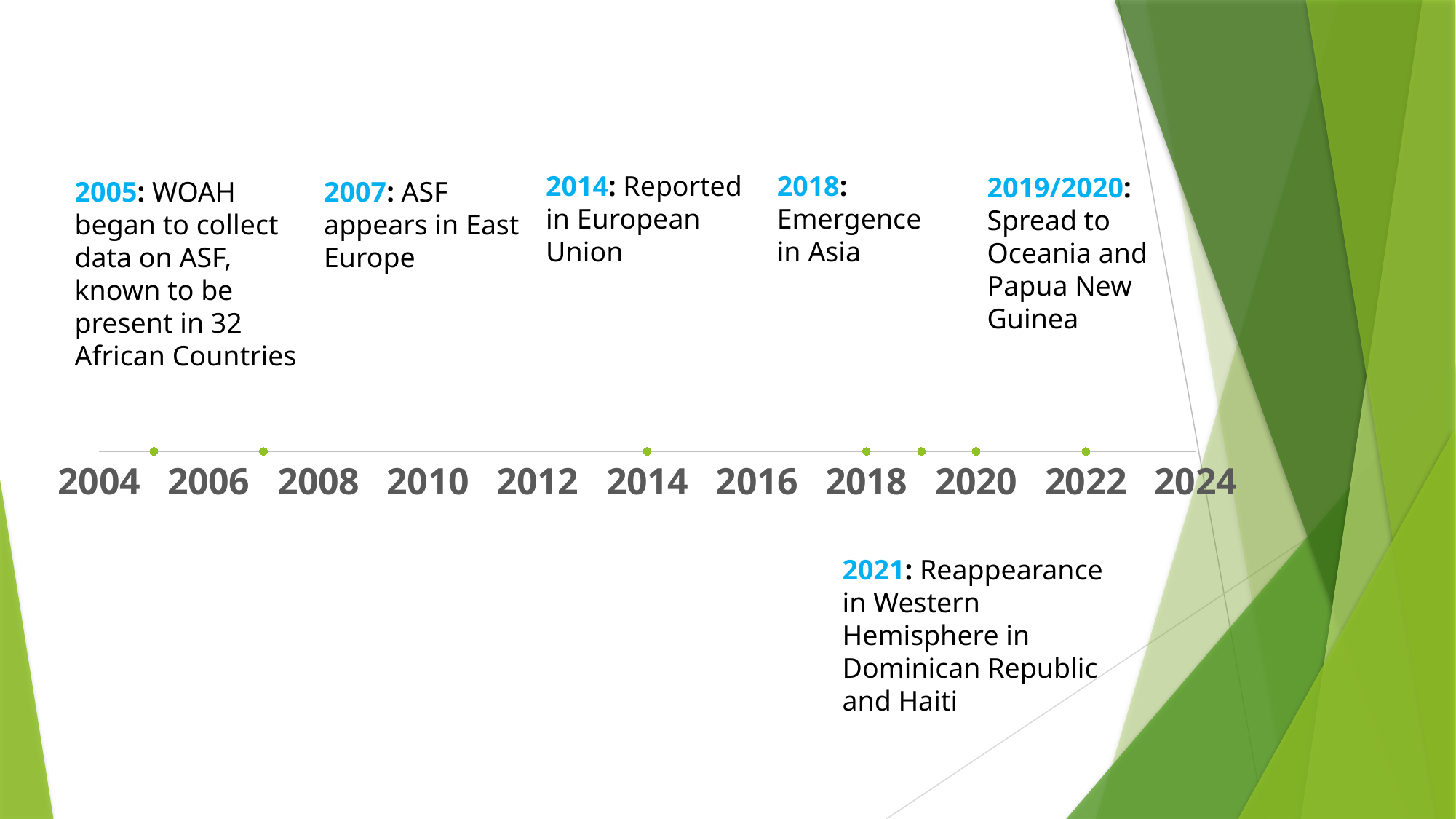
What is the earliest event year marked on the timeline? 2005 What is the last year labelled on the timeline axis? 2024 In which year did WOAH begin to collect data on ASF, according to the timeline? 2005 In which year does the timeline say ASF appeared in East Europe? 2007 Which years are given for the spread to Oceania and Papua New Guinea? 2019/2020 In which year does the timeline record the reappearance of ASF in the Western Hemisphere? 2021 What kind of chart is shown on the slide? A timeline What is the first year labelled on the timeline axis? 2004 What event does the timeline record for 2018? Emergence in Asia What event does the timeline record for 2014? Reported in European Union How many event markers (dots) are plotted on the timeline? 7